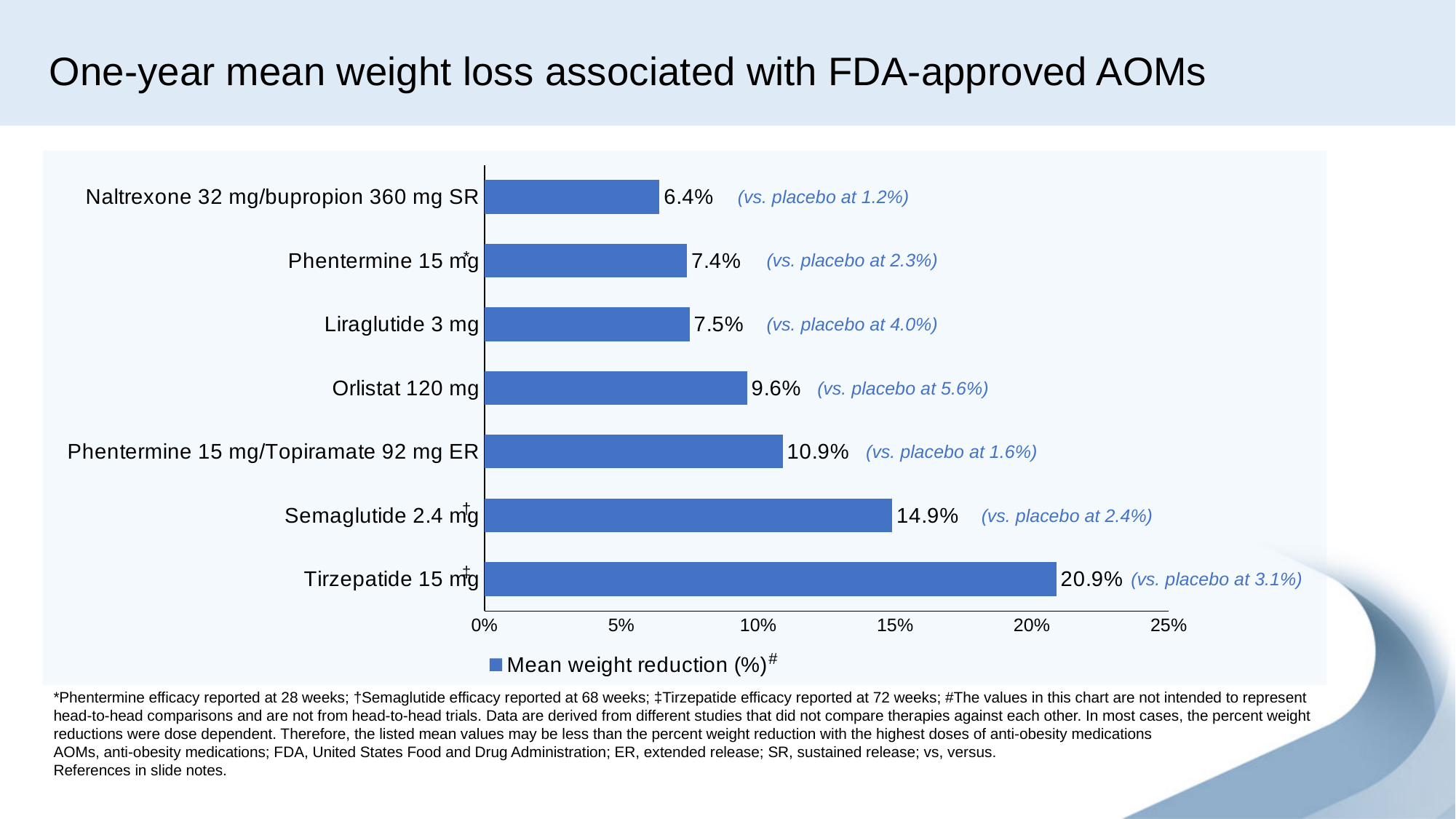
Which medication has the highest mean weight reduction? Tirzepatide 15 mg What is the legend entry for the plotted series? Mean weight reduction (%) What is the difference in mean weight reduction between Tirzepatide 15 mg and Semaglutide 2.4 mg? 6.0% What type of chart is shown on the slide? Bar chart What is the difference in mean weight reduction between Phentermine 15 mg/Topiramate 92 mg ER and Orlistat 120 mg? 1.3% What is the mean weight reduction for Liraglutide 3 mg? 7.5% How many medications are shown in the chart? 7 Which has a larger mean weight reduction, Semaglutide 2.4 mg or Phentermine 15 mg/Topiramate 92 mg ER? Semaglutide 2.4 mg What is the mean weight reduction for Orlistat 120 mg? 9.6% What is the mean weight reduction for Tirzepatide 15 mg? 20.9% Which medication has the lowest mean weight reduction? Naltrexone 32 mg/bupropion 360 mg SR Is the value for Semaglutide 2.4 mg greater or less than 10%? greater